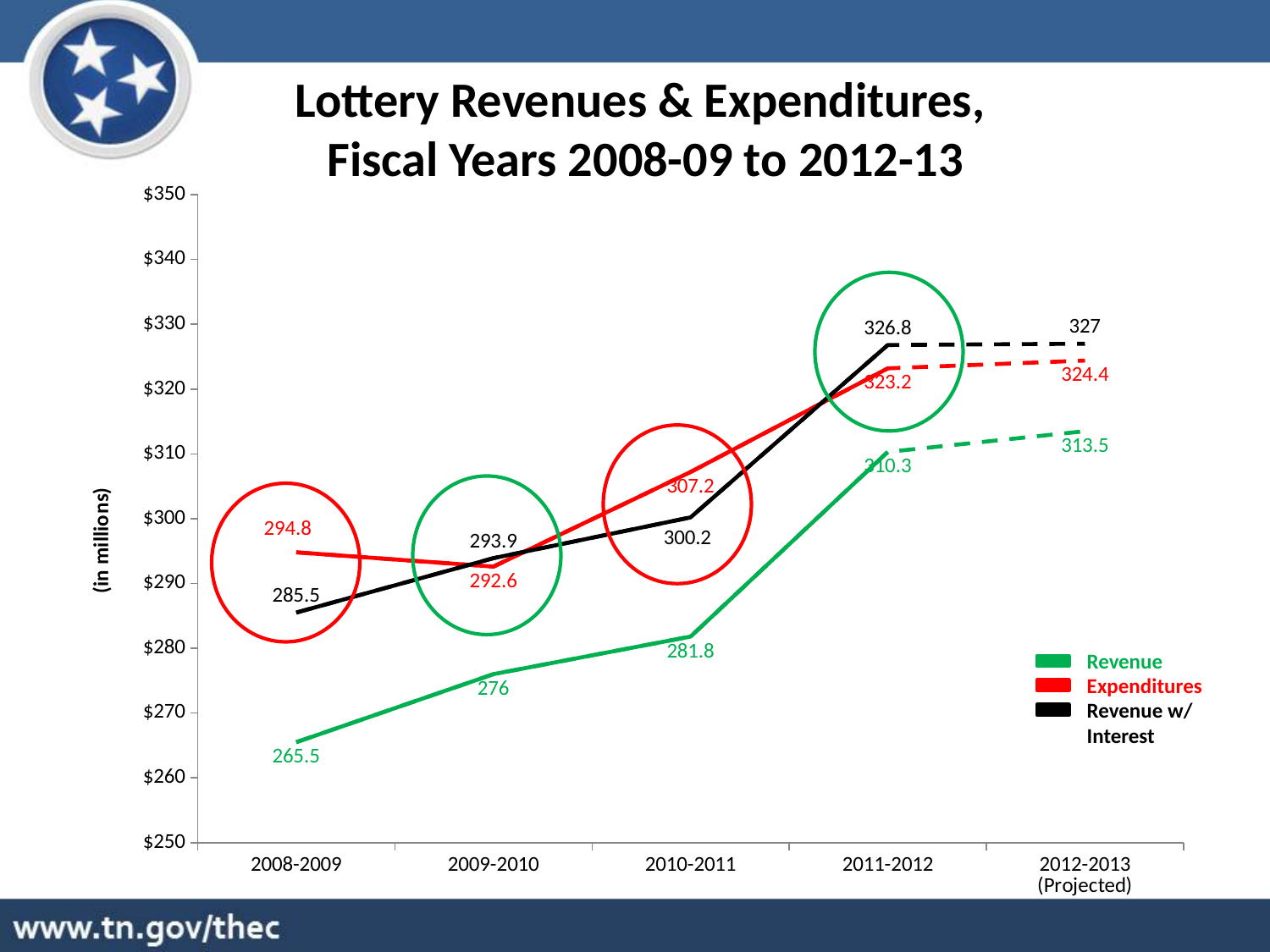
What is the projected Revenue value for 2012-2013? 313.5 How many fiscal years are plotted along the x axis? 5 What is the Expenditures value for 2010-2011? 307.2 Does Revenue rise or fall from 2008-2009 to 2012-2013? Rise In which fiscal year is Revenue lowest? 2008-2009 What is the Revenue value for 2008-2009? 265.5 In 2011-2012, which is larger: Revenue w/ Interest or Expenditures? Revenue w/ Interest In which fiscal year is Revenue w/ Interest highest? 2012-2013 (Projected) What type of chart is shown on the slide? Line chart What is the Revenue w/ Interest value for 2011-2012? 326.8 How many series does the legend list? 3 What is the difference between Expenditures and Revenue in 2009-2010? 16.6